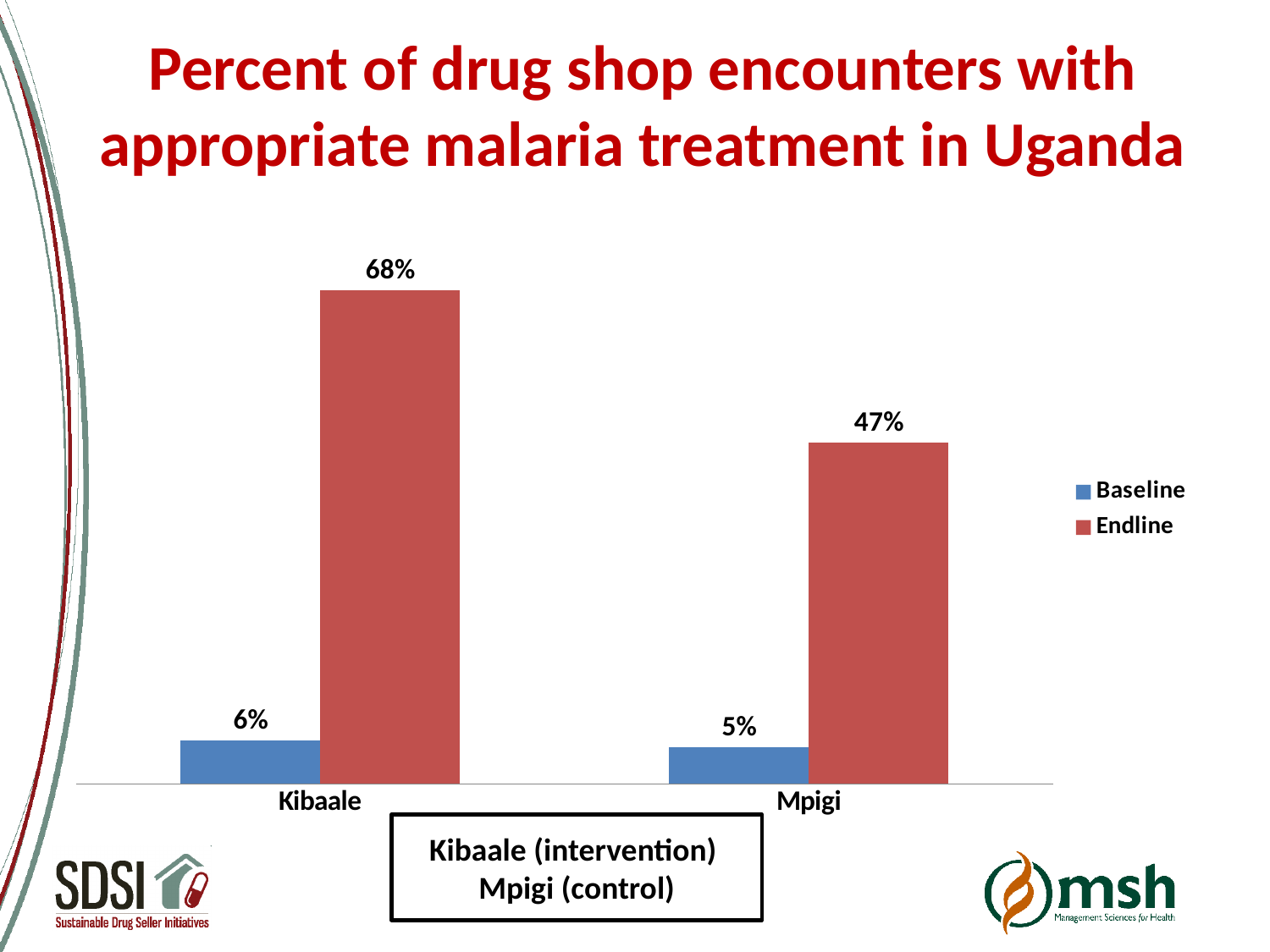
Which district has the highest Endline value? Kibaale What is the difference between the Endline and Baseline values for Kibaale? 62% What is the Endline value for Mpigi? 47% How many series does the legend list? 2 What is the Baseline value for Mpigi? 5% What kind of chart is shown on the slide? Bar chart What is the difference between the Endline values for Kibaale and Mpigi? 21% How many districts are shown on the x axis? 2 Which district has the lowest Baseline value? Mpigi Which is larger, the Endline value for Mpigi or the Endline value for Kibaale? Kibaale What is the Baseline value for Kibaale? 6% What is the Endline value for Kibaale? 68%